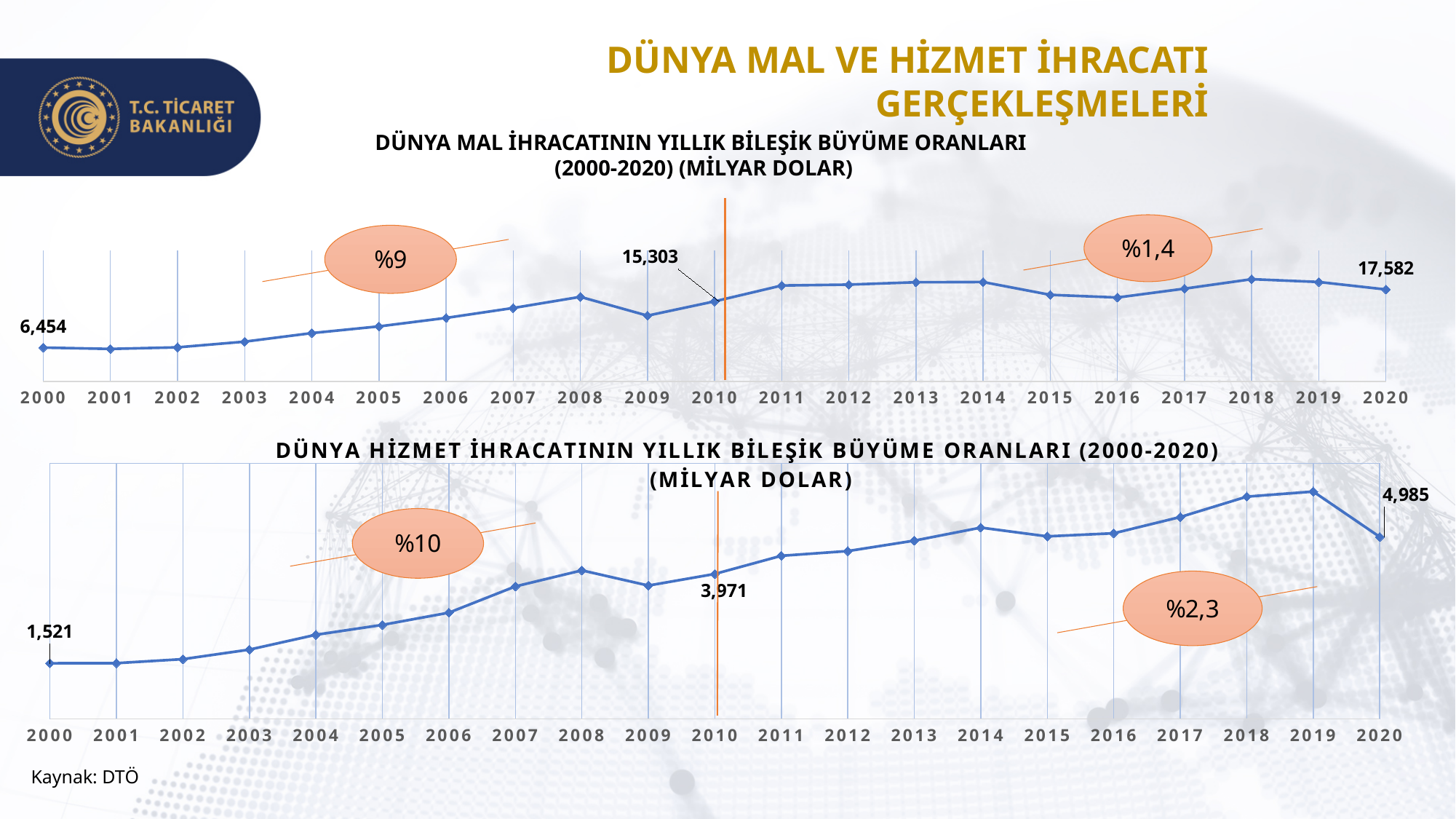
In the top chart (Dünya Mal İhracatı), what is the value for 2020? 17,582 In the top chart (Dünya Mal İhracatı), what is the difference between the 2020 value and the 2000 value? 11,128 In the top chart (Dünya Mal İhracatı), do the values generally rise or fall from 2000 to 2020? Rise How many years are plotted on the x axis of the bottom chart (Dünya Hizmet İhracatı)? 21 In the top chart (Dünya Mal İhracatının Yıllık Bileşik Büyüme Oranları), what is the value for 2000? 6,454 In the bottom chart (Dünya Hizmet İhracatı), what is the value for 2000? 1,521 In the bottom chart (Dünya Hizmet İhracatı), what is the difference between the 2010 value and the 2000 value? 2,450 In the top chart (Dünya Mal İhracatı), what is the value for 2010? 15,303 In the bottom chart (Dünya Hizmet İhracatı), which year has the highest value? 2019 In the bottom chart (Dünya Hizmet İhracatı), what is the value for 2020? 4,985 In the top chart (Dünya Mal İhracatı), which is larger, the value for 2008 or the value for 2009? 2008 What kind of chart is the top chart (Dünya Mal İhracatı)? Line chart